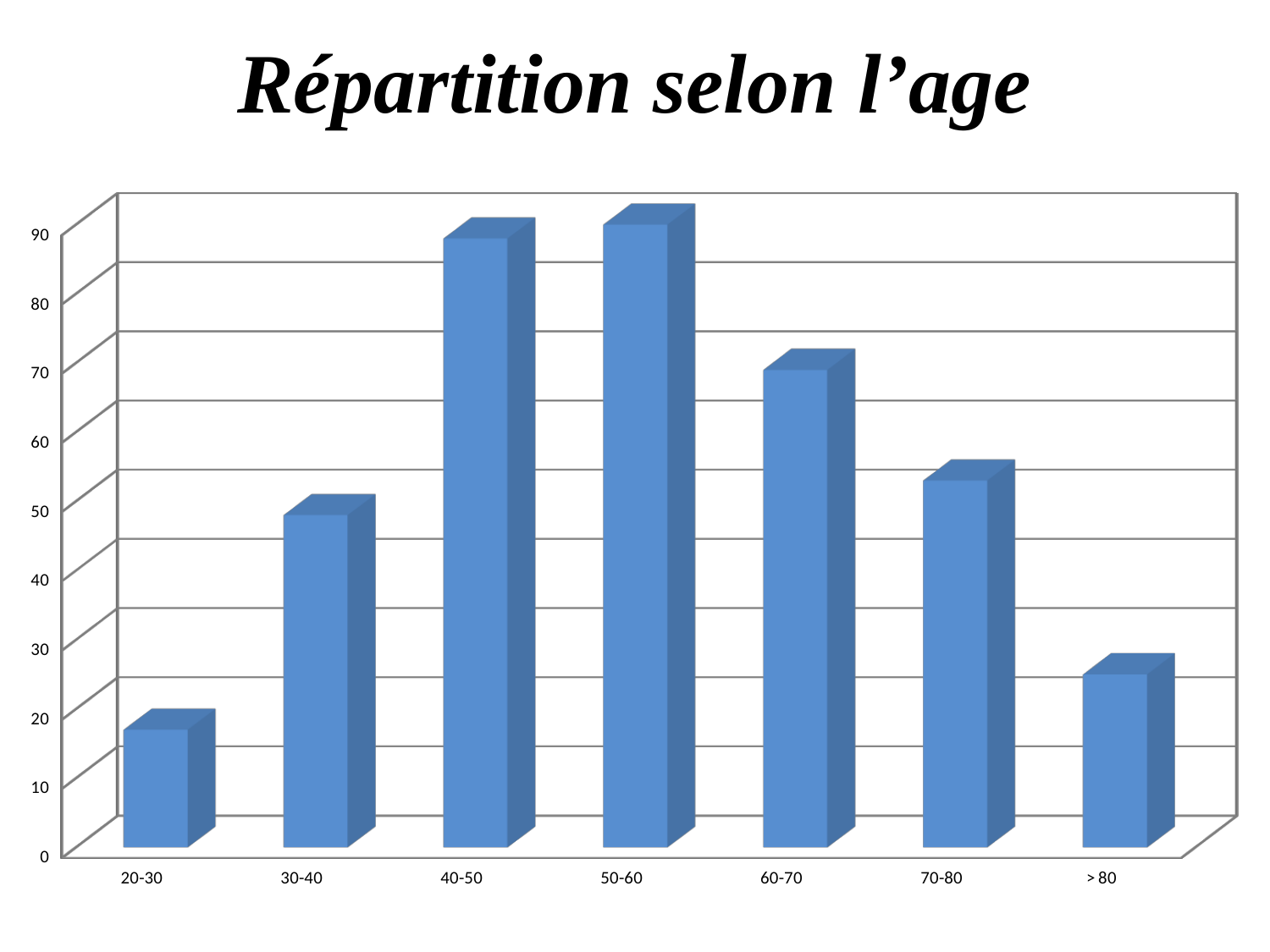
Is the value for 20-30 greater or less than 30? less Is the value for 40-50 greater or less than 80? greater Which is larger, the value for 60-70 or the value for 70-80? 60-70 Is the value for > 80 greater or less than 30? less Which is larger, the value for 30-40 or the value for > 80? 30-40 Which age category has the lowest value? 20-30 What is the title of the chart? Répartition selon l'age How many age categories are shown on the x axis? 7 What kind of chart is shown on the slide? bar chart